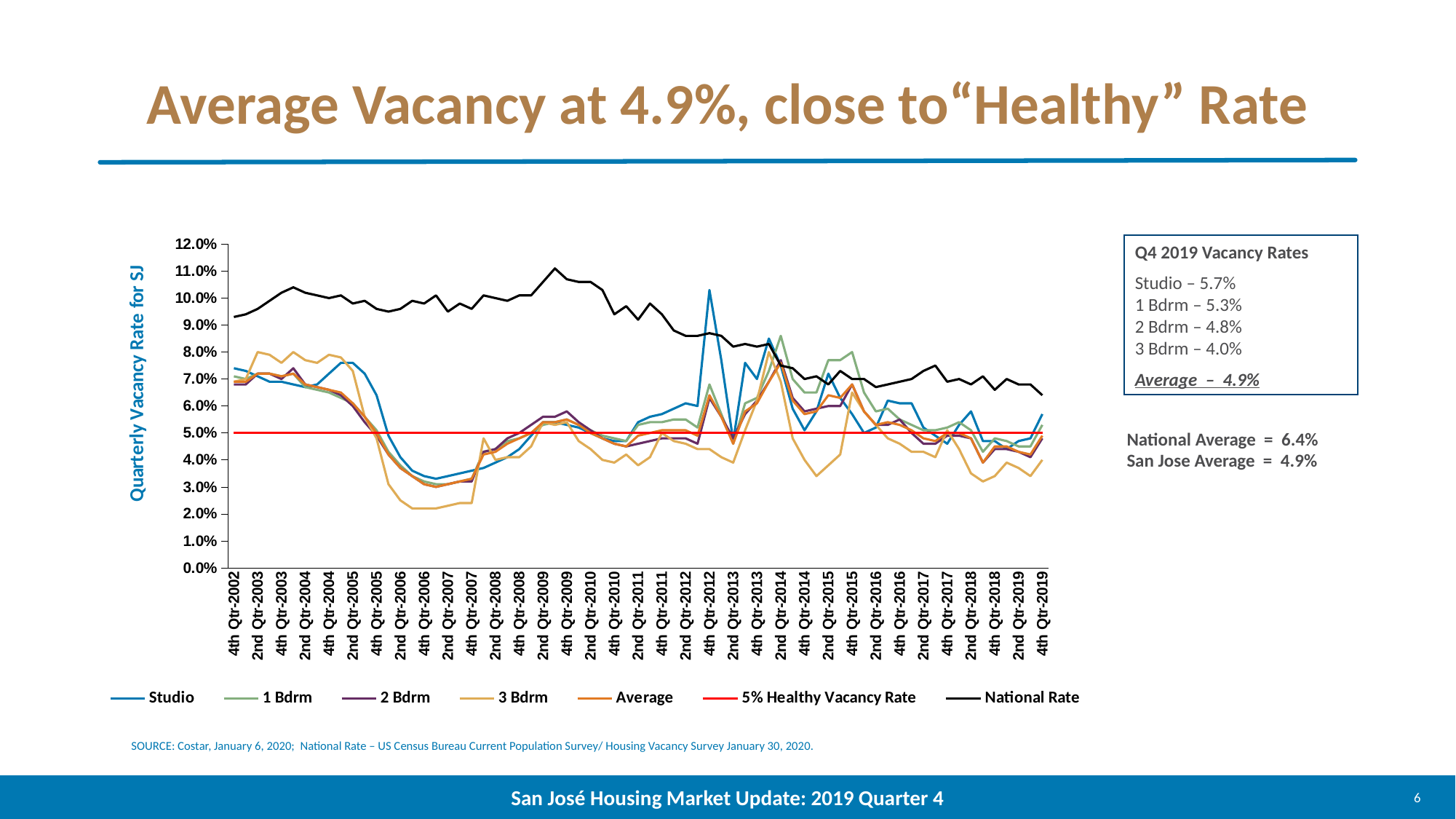
What is the difference between the Studio and 3 Bdrm vacancy rates in Q4 2019? 1.7 percentage points What is the 3 Bdrm vacancy rate for Q4 2019? 4.0% Does the National Rate line rise or fall between 4th Qtr-2013 and 4th Qtr-2019? Falls Among Studio, 1 Bdrm, 2 Bdrm and 3 Bdrm, which unit type has the lowest vacancy rate in Q4 2019? 3 Bdrm What kind of chart is shown on the slide? Line chart What is the Studio vacancy rate for Q4 2019? 5.7% What is the title of the chart's vertical axis? Quarterly Vacancy Rate for SJ In Q4 2019, which is higher: the Studio vacancy rate or the 2 Bdrm vacancy rate? Studio Is the National Rate at 4th Qtr-2009 greater or less than 10.0%? greater What is the National Rate vacancy value for Q4 2019? 6.4% Is the 3 Bdrm vacancy rate at 4th Qtr-2006 greater or less than 3.0%? less How many series does the chart's legend list? 7